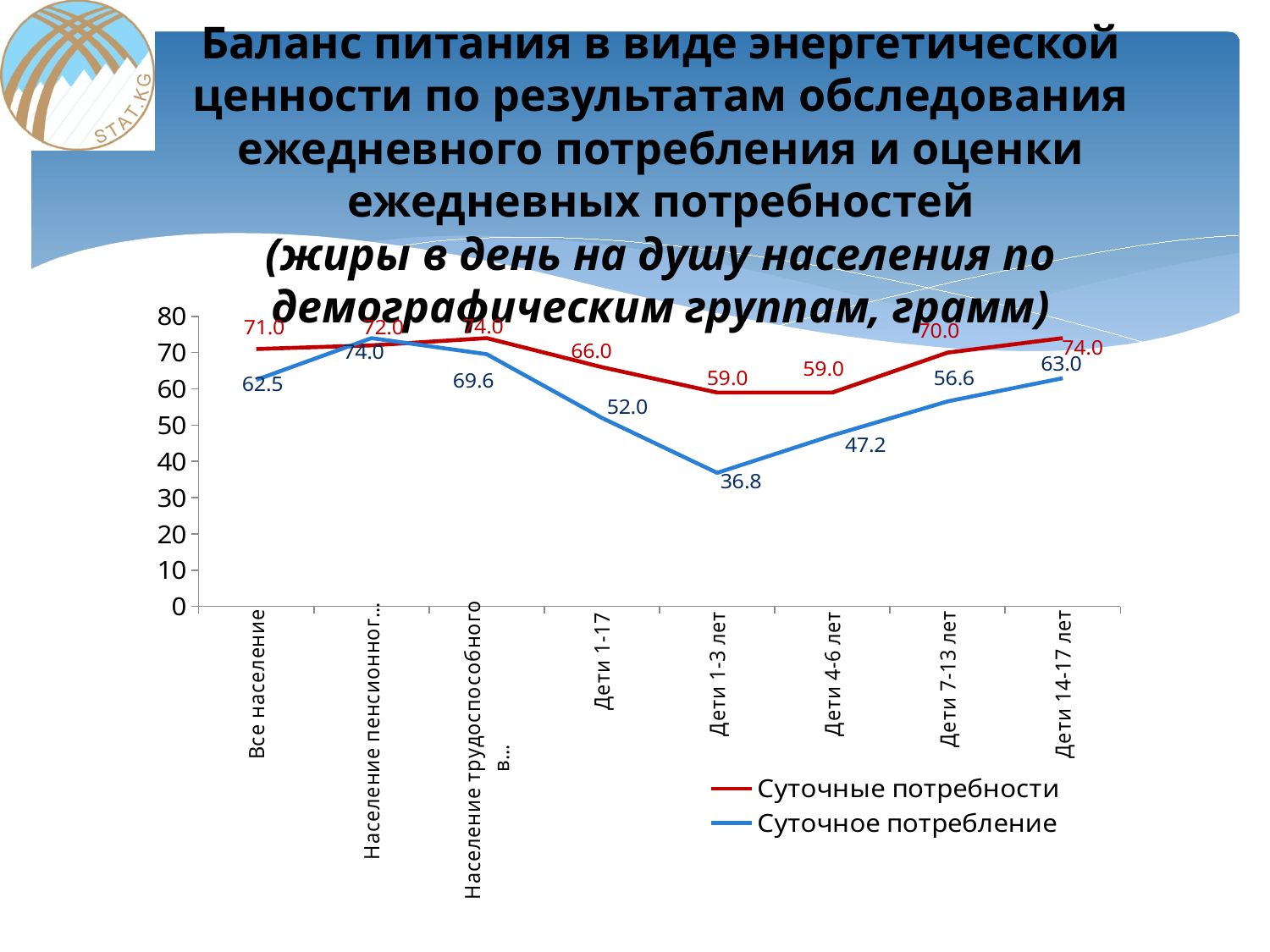
What colour is the line for Суточное потребление? Blue What is the value of Суточные потребности for Все население? 71.0 Which demographic group has the lowest value of Суточное потребление? Дети 1-3 лет How many series does the legend list? 2 What type of chart is shown on the slide? Line chart For Дети 4-6 лет, which is larger: Суточные потребности or Суточное потребление? Суточные потребности How many demographic groups are plotted along the x axis? 8 Is the value of Суточное потребление for Дети 1-17 greater or less than 60? less What is the difference between Суточные потребности and Суточное потребление for Дети 1-3 лет? 22.2 What is the value of Суточное потребление for Дети 7-13 лет? 56.6 Which demographic group has the highest value of Суточное потребление? Население пенсионного возраста What is the value of Суточное потребление for Дети 1-3 лет? 36.8